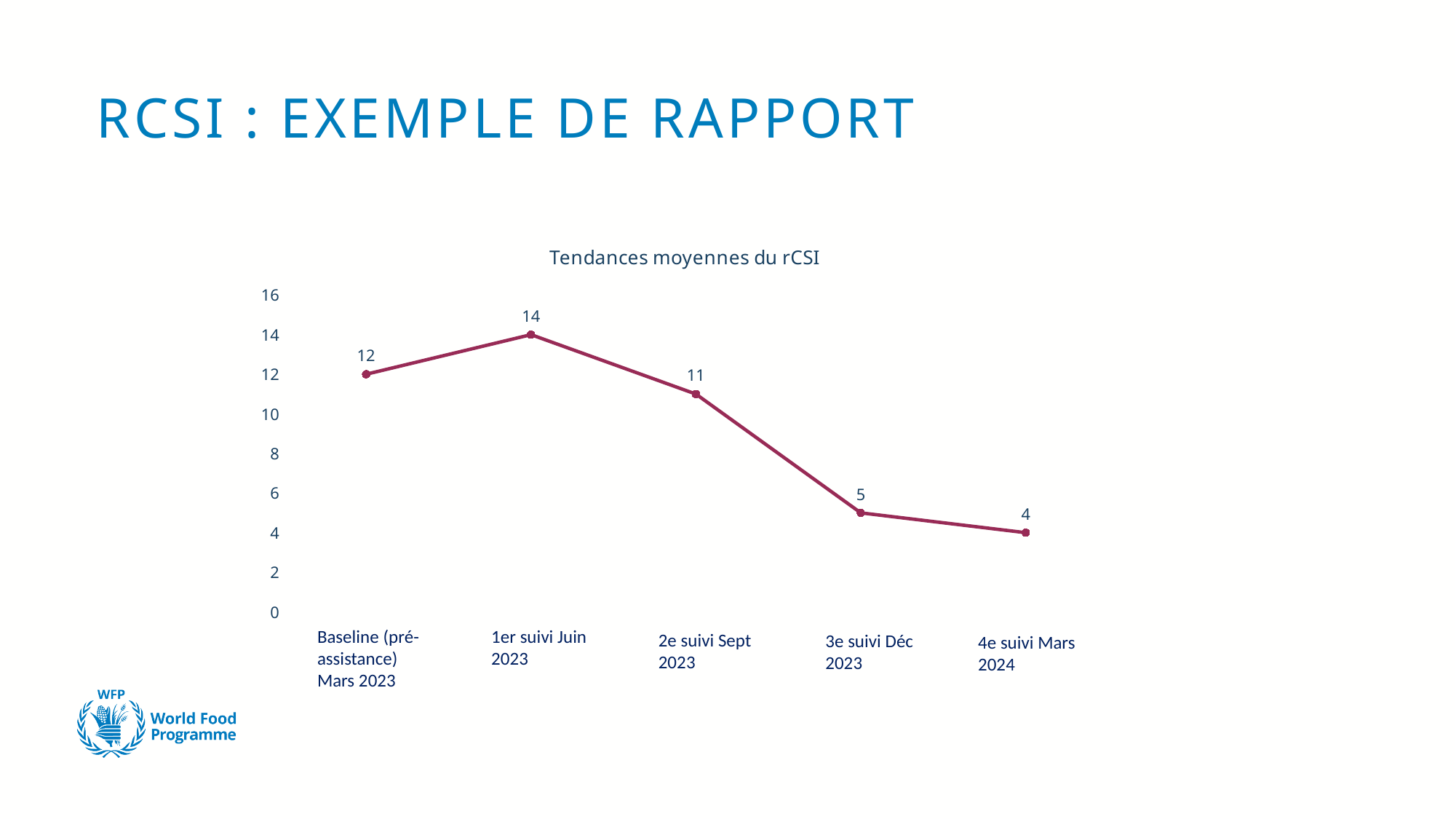
What kind of chart is shown on the slide? line chart What is the value for 1er suivi Juin 2023? 14 How many data points are plotted on the chart? 5 Do the values rise or fall from 1er suivi Juin 2023 to 4e suivi Mars 2024? fall Which point has the lowest value? 4e suivi Mars 2024 What is the value for 4e suivi Mars 2024? 4 Which is larger, the value for Baseline (pré-assistance) Mars 2023 or the value for 2e suivi Sept 2023? Baseline (pré-assistance) Mars 2023 Which point has the highest value? 1er suivi Juin 2023 What is the value for Baseline (pré-assistance) Mars 2023? 12 What is the title of the chart? Tendances moyennes du rCSI Is the value for 3e suivi Déc 2023 greater or less than 8? less What is the difference between the values for 2e suivi Sept 2023 and 3e suivi Déc 2023? 6